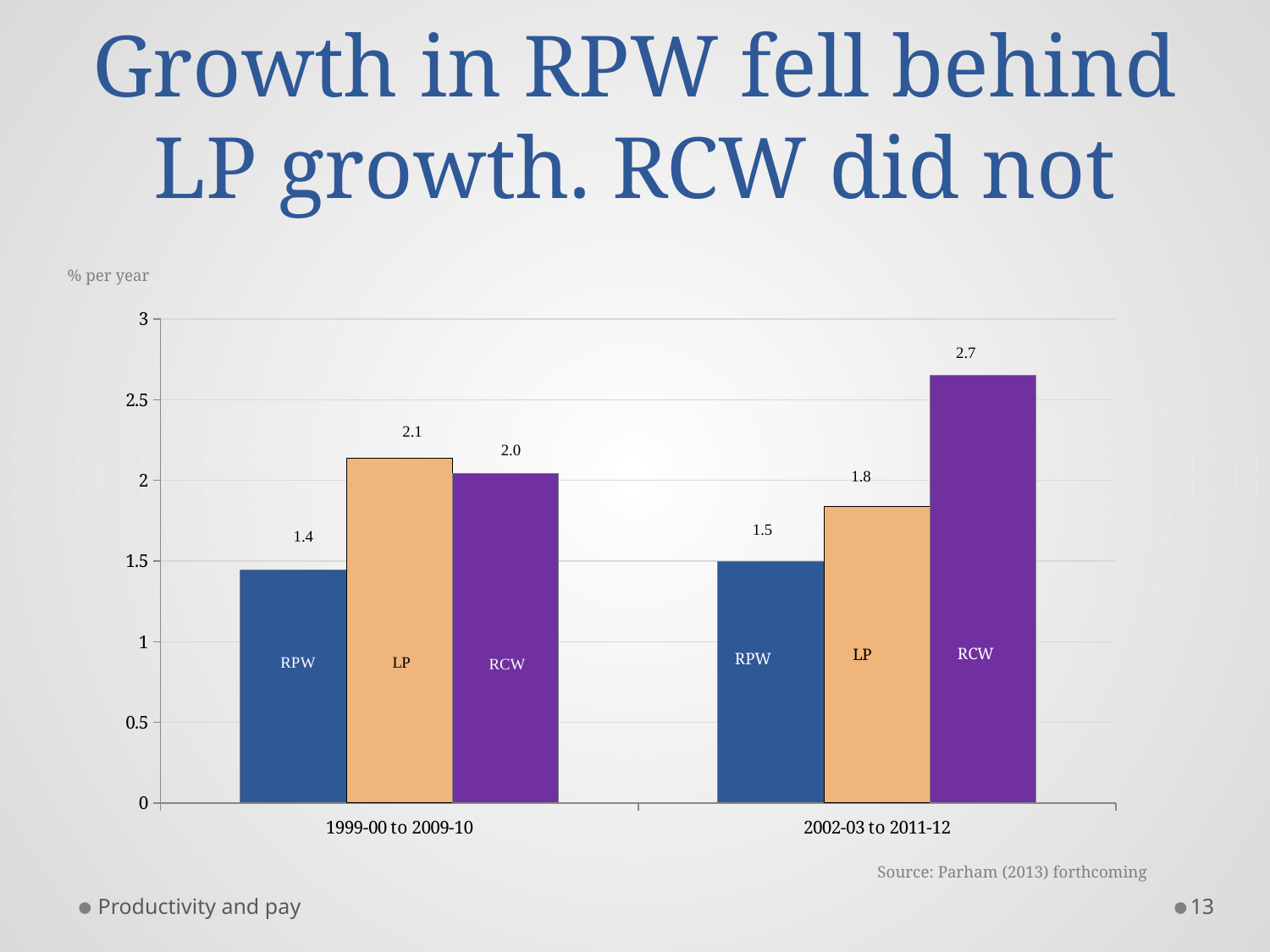
What is the value for RCW in the 2002-03 to 2011-12 period? 2.7 Which is larger in the 1999-00 to 2009-10 period, LP or RCW? LP What is the difference between the RCW and RPW values in the 2002-03 to 2011-12 period? 1.2 What is the value for LP in the 2002-03 to 2011-12 period? 1.8 What is the value for RPW in the 1999-00 to 2009-10 period? 1.4 Is the value for RCW in the 2002-03 to 2011-12 period greater or less than 2.5? greater How many time periods are shown on the x axis? 2 What unit is shown above the chart's y axis? % per year Which series has the lowest value in the 1999-00 to 2009-10 period? RPW What is the difference between the LP and RPW values in the 1999-00 to 2009-10 period? 0.7 Which series has the highest value in the 2002-03 to 2011-12 period? RCW What kind of chart is shown on the slide? Bar chart